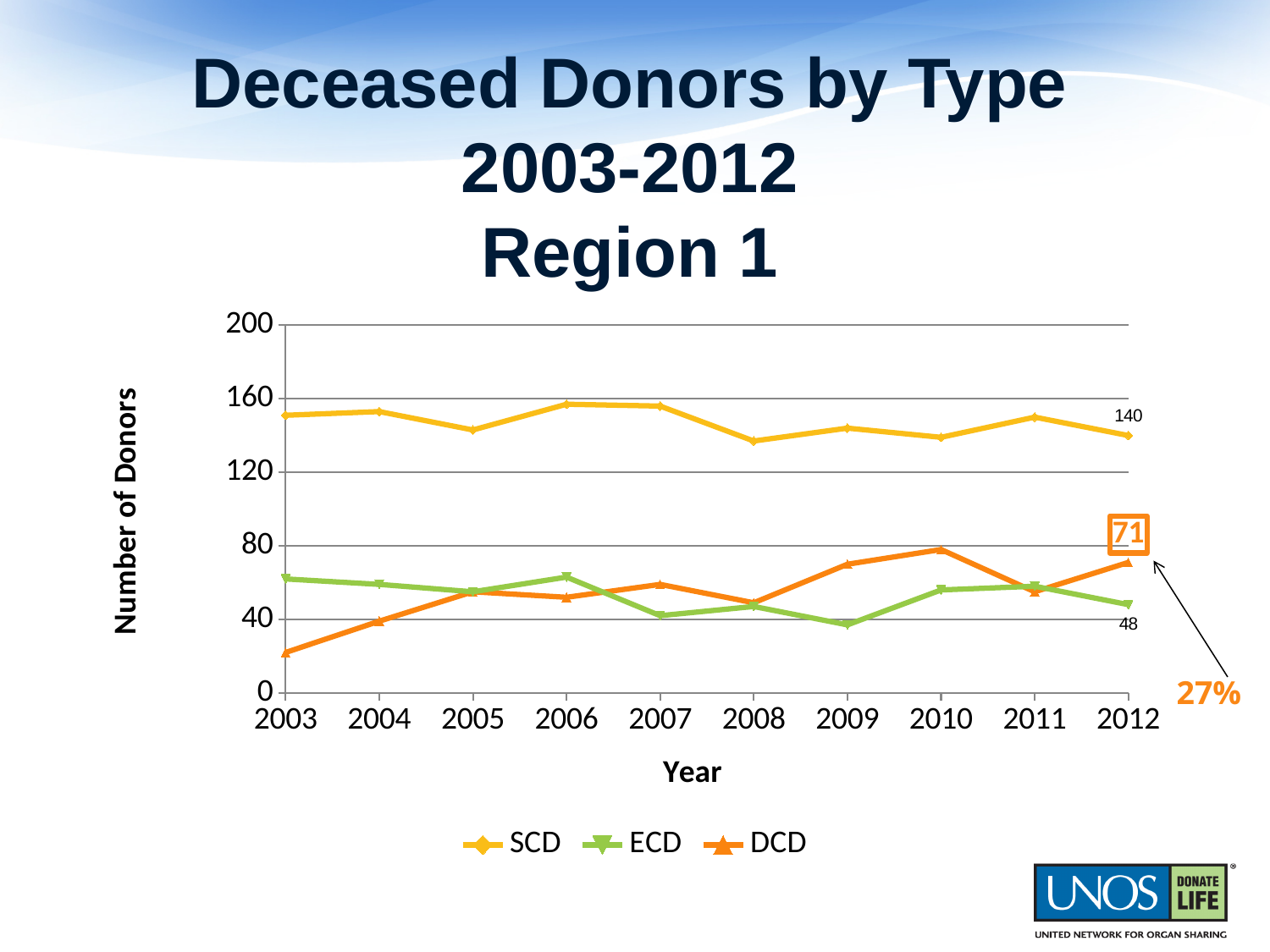
How many series does the legend list? 3 What is the value for SCD in 2012? 140 What is the value for DCD in 2012? 71 What kind of chart is shown on the slide? line chart What is the difference between the SCD and DCD values in 2012? 69 In which year is the DCD value lowest? 2003 Is the value for DCD in 2003 greater or less than 40? less What is the title of the y axis? Number of Donors Is the value for SCD in 2006 greater or less than 120? greater In 2012, which is larger, the DCD value or the ECD value? DCD How many years are shown on the x axis? 10 What is the value for ECD in 2012? 48